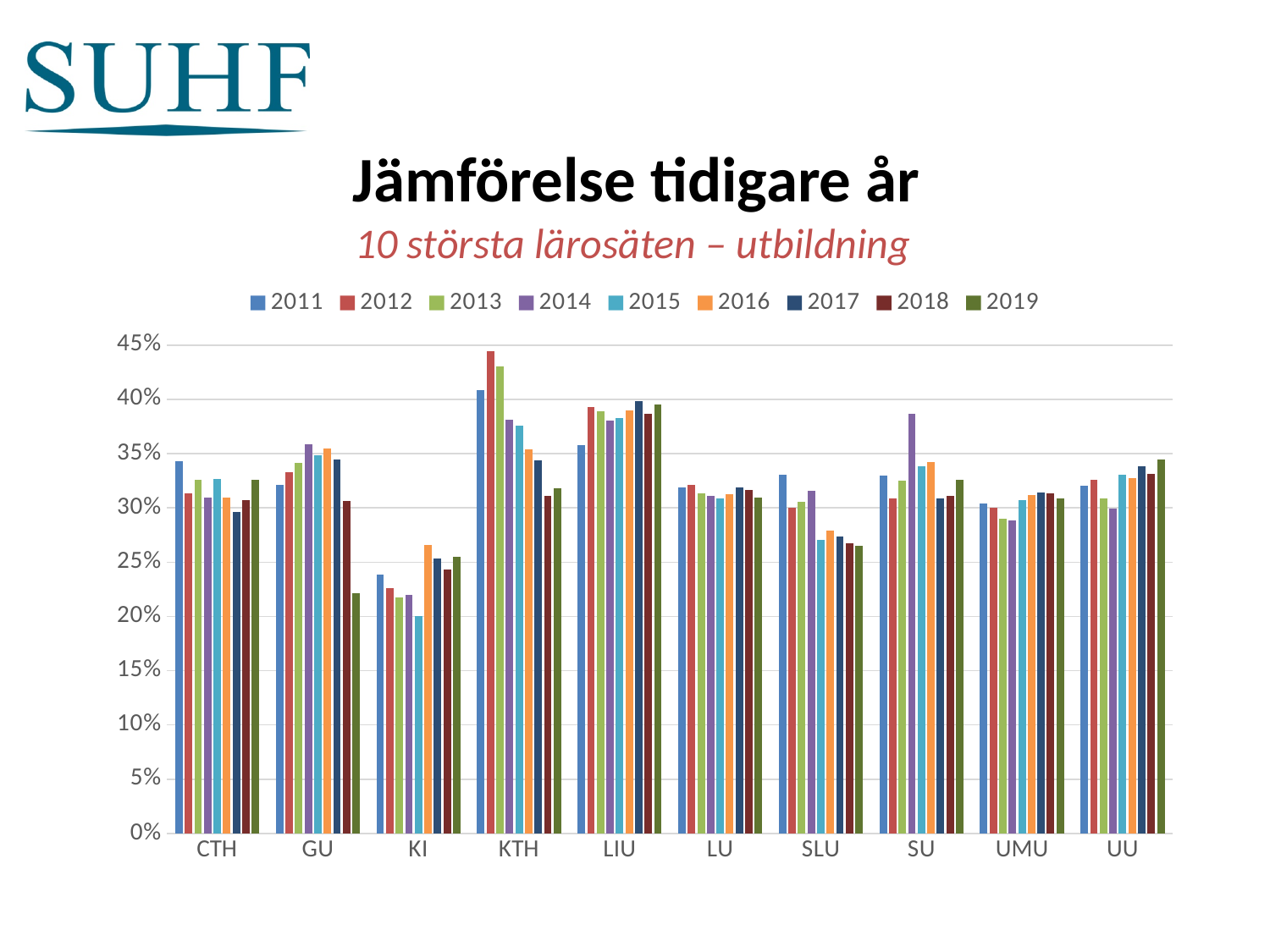
How many institutions (categories) are shown on the x axis? 10 Which institution has the tallest bar in the chart? KTH How many series (years) does the legend list? 9 Which is larger, the 2011 value for KTH or the 2011 value for LIU? KTH Which institution has the shortest bar in the chart? KI Is the value for KI in 2015 greater or less than 25%? less Is the value for GU in 2019 greater or less than 25%? less Is the value for SU in 2014 greater or less than 35%? greater What kind of chart is shown on the slide? bar chart For SU, which year has the highest value? 2014 What is the title of the chart? Jämförelse tidigare år